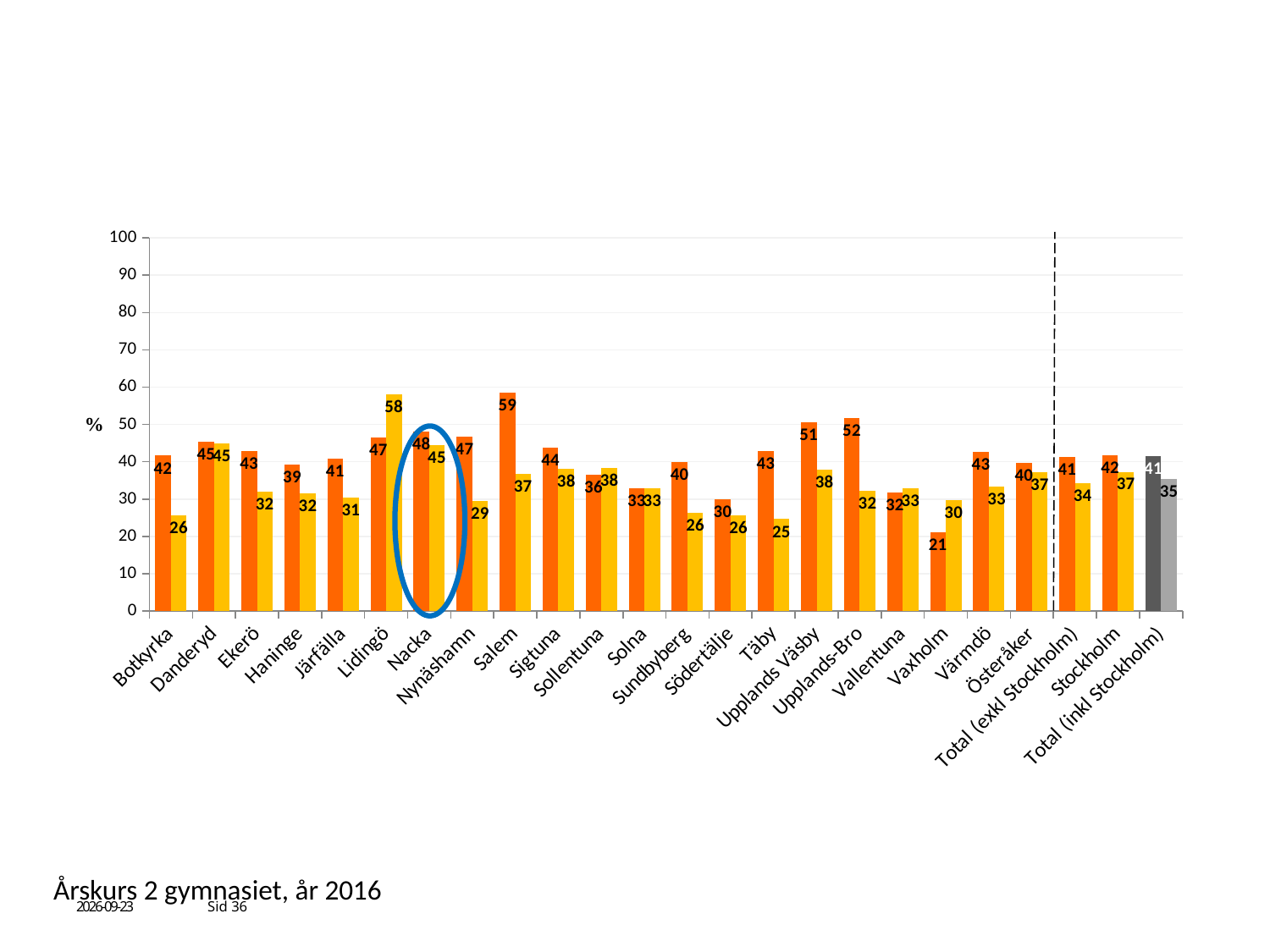
What is the value of the yellow (right) bar for Total (inkl Stockholm)? 35 Which municipality has the highest orange (left) bar? Salem How many categories are shown on the x axis? 24 What is the value of the orange (left) bar for Nacka, the circled municipality? 48 What is the value of the orange (left) bar for Salem? 59 What kind of chart is shown on the slide? bar chart What is the difference between the orange bar and the yellow bar for Botkyrka? 16 What is the value of the yellow (right) bar for Lidingö? 58 Which category has the lowest yellow (right) bar? Täby Which municipality has the lowest orange (left) bar? Vaxholm Is the orange (left) bar for Upplands-Bro greater or less than 50? greater Which is larger for Vaxholm, the orange (left) bar or the yellow (right) bar? the yellow (right) bar